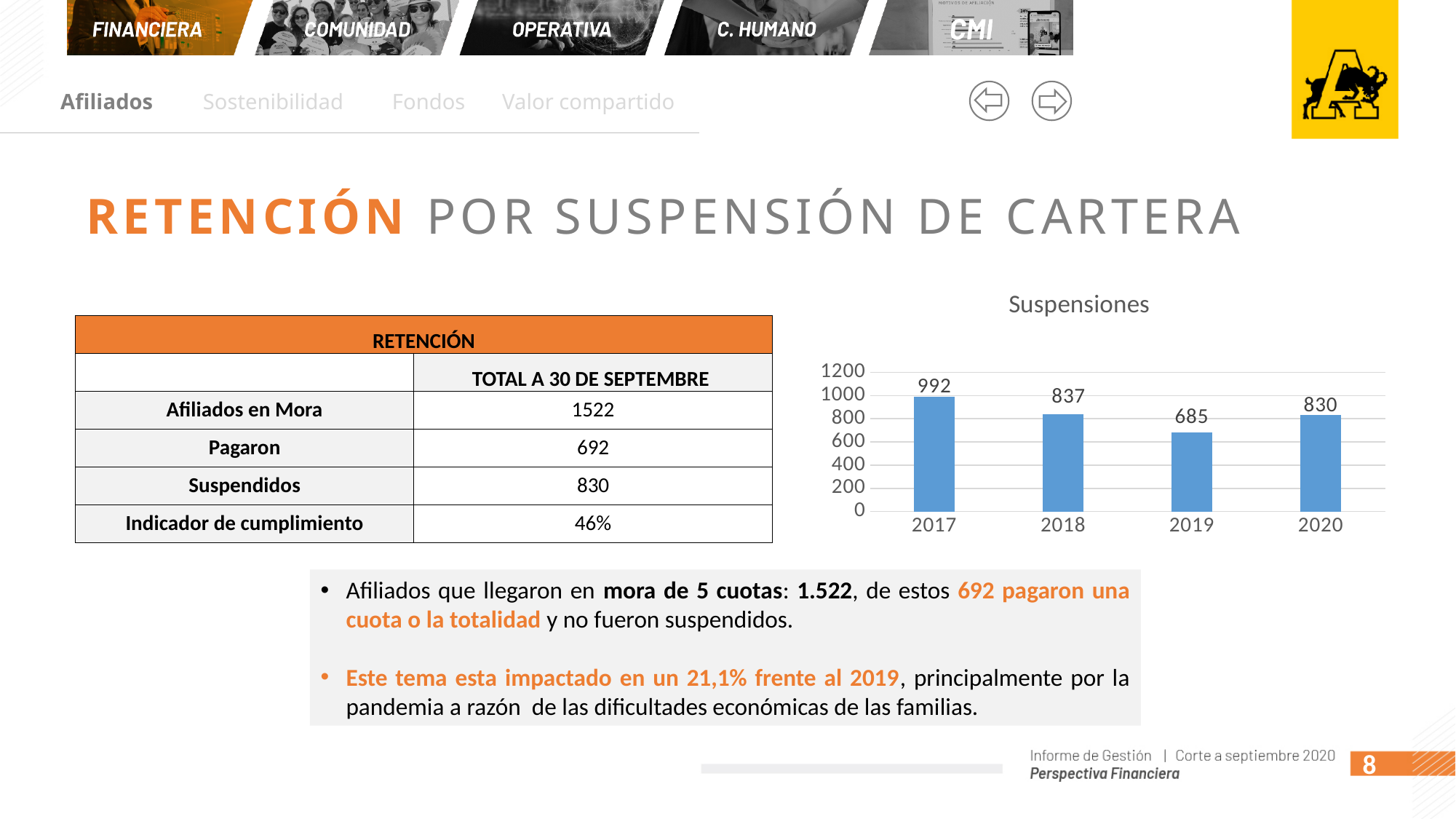
What is the value for 2019 in the Suspensiones chart? 685 What is the difference between the 2020 and 2019 values in the Suspensiones chart? 145 How many years are shown in the Suspensiones chart? 4 In the Suspensiones chart, which is larger: the value for 2018 or the value for 2020? 2018 Which year has the lowest value in the Suspensiones chart? 2019 What is the value for 2020 in the Suspensiones chart? 830 What kind of chart is the Suspensiones chart? bar chart Which year has the highest value in the Suspensiones chart? 2017 What is the title of the chart on the slide? Suspensiones Is the value for 2019 in the Suspensiones chart greater or less than 800? less What is the value for 2017 in the Suspensiones chart? 992 What is the difference between the 2017 and 2018 values in the Suspensiones chart? 155